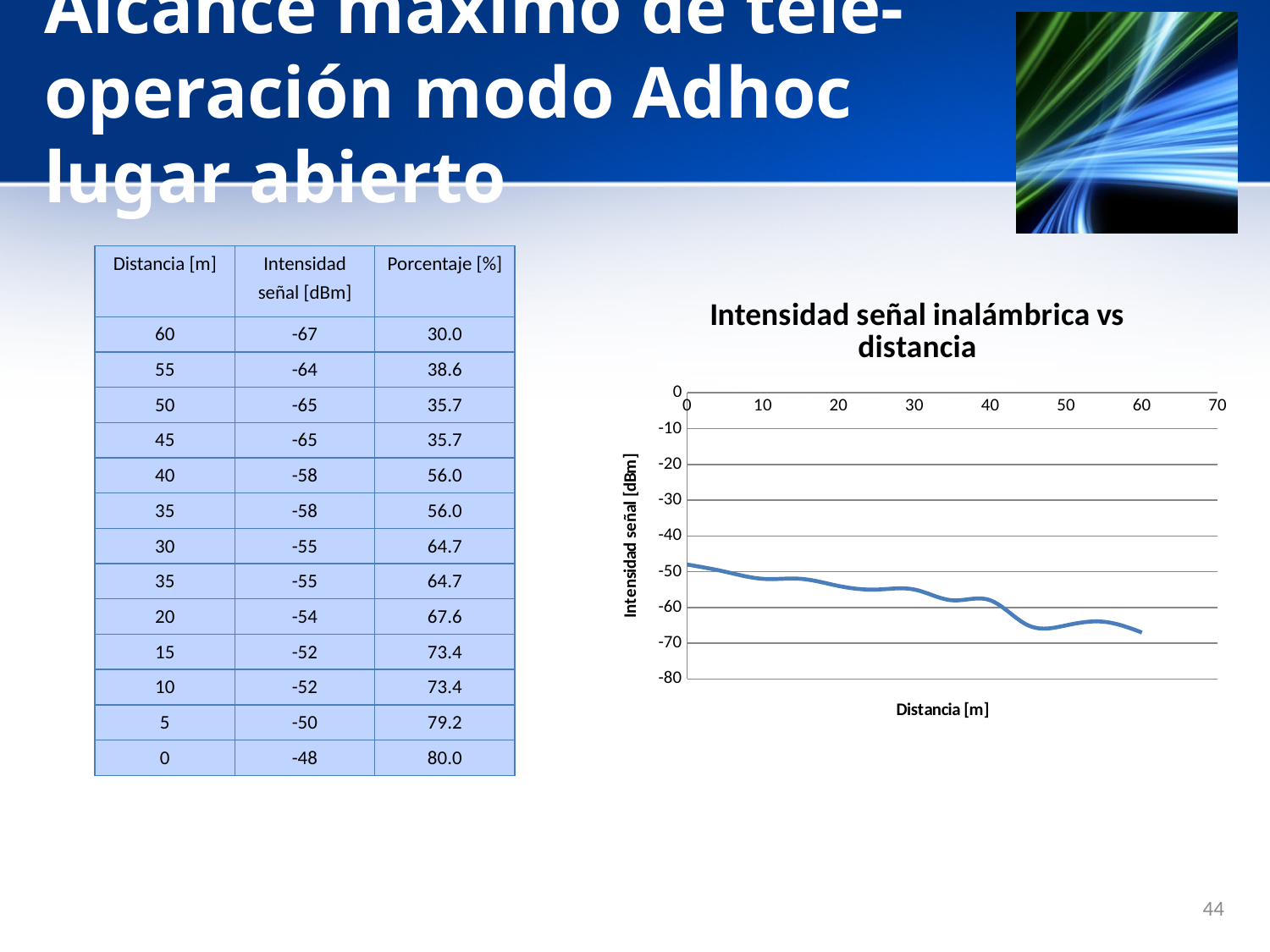
What is the difference in signal intensity between 0 m and 60 m? 19 dBm In the chart, is the signal intensity at 60 m greater or less than -60 dBm? less In the chart, is the signal intensity at 0 m greater or less than -40 dBm? less What is the signal intensity at 0 m, as given in the table? -48 dBm Which has the stronger signal intensity, 10 m or 50 m? 10 m In the chart 'Intensidad señal inalámbrica vs distancia', does the signal intensity rise or fall as distance increases? fall At which distance is the signal intensity lowest in the chart? 60 m What is the signal intensity at 60 m, as given in the table? -67 dBm What kind of chart is shown on the slide? line chart At which distance is the signal intensity highest in the chart? 0 m In the chart, is the signal intensity at 20 m greater or less than -60 dBm? greater What is the title of the chart's vertical axis? Intensidad señal [dBm]